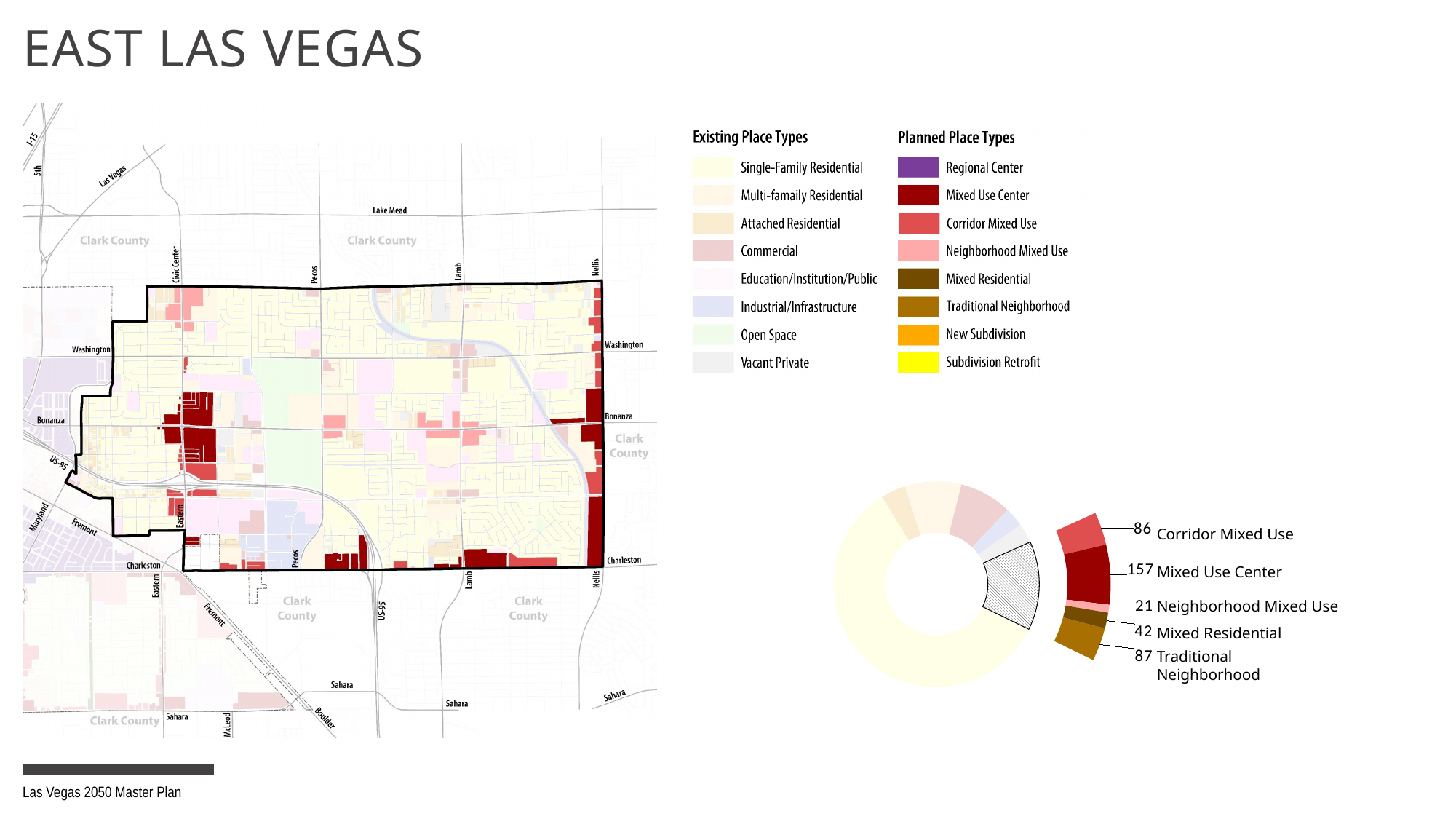
In the donut chart, which is larger: Mixed Residential or Traditional Neighborhood? Traditional Neighborhood In the donut chart, what is the value for Mixed Residential? 42 In the donut chart, what is the value for Corridor Mixed Use? 86 In the donut chart, what is the value for Neighborhood Mixed Use? 21 What is the total of the five labeled planned place type values in the donut chart? 393 What kind of chart is shown on the right side of the slide? Donut (pie) chart In the donut chart, what is the value for Traditional Neighborhood? 87 In the donut chart, what is the value for Mixed Use Center? 157 In the donut chart, what is the difference between the values for Mixed Use Center and Corridor Mixed Use? 71 How many labeled planned place type segments are broken out in the donut chart? 5 Among the labeled planned place types in the donut chart, which has the lowest value? Neighborhood Mixed Use Among the labeled planned place types in the donut chart, which has the highest value? Mixed Use Center